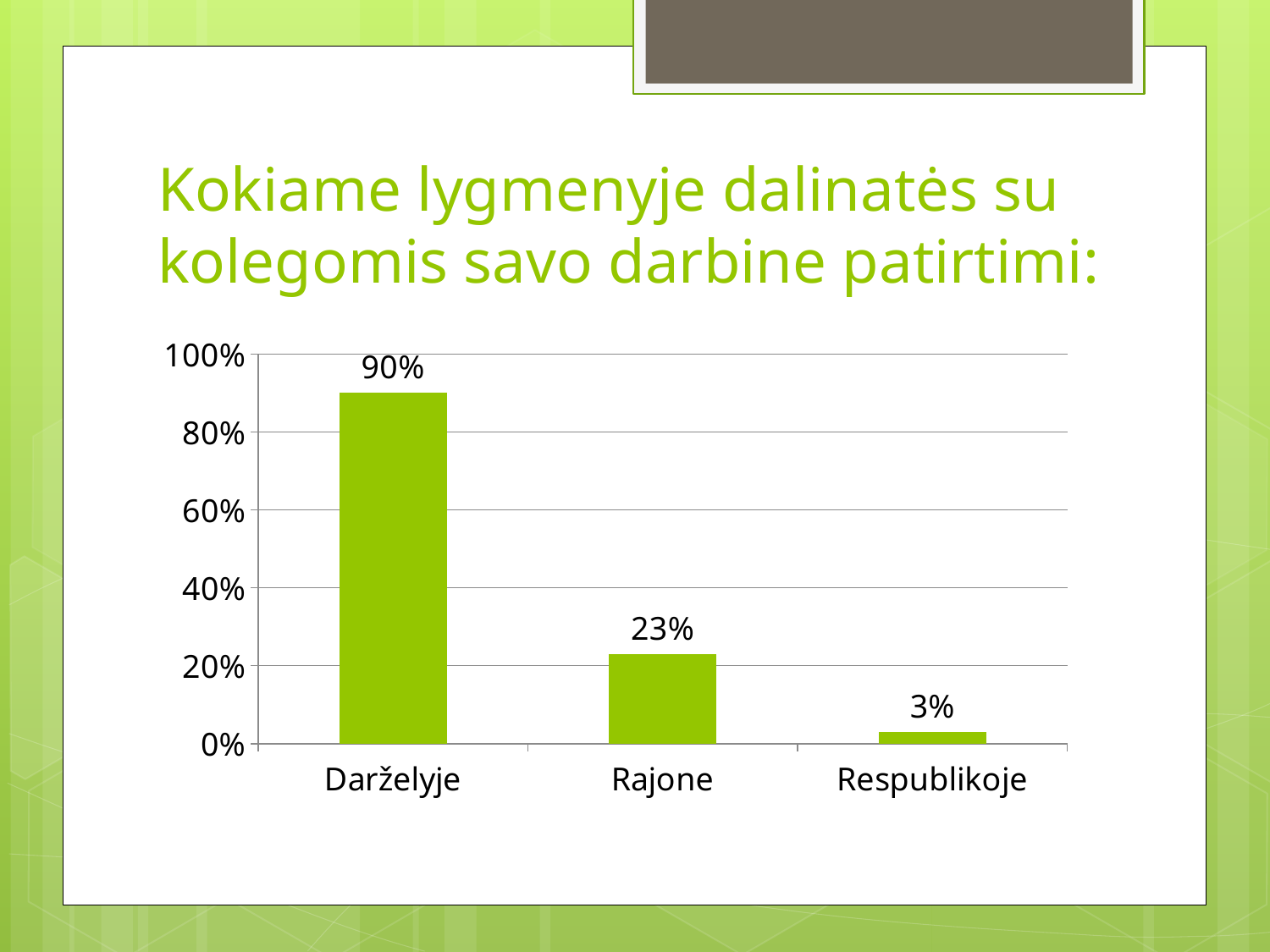
Which is larger, the value for Rajone or the value for Respublikoje? Rajone Do the values rise or fall from left to right along the x axis? fall Is the value for Darželyje greater or less than 80%? greater How many categories are shown on the x axis? 3 What is the difference between the values for Darželyje and Rajone? 67% Which category has the lowest value? Respublikoje What is the value for Respublikoje? 3% What is the value for Rajone? 23% What kind of chart is shown on the slide? bar chart Which category has the highest value? Darželyje What is the difference between the values for Rajone and Respublikoje? 20% What is the value for Darželyje? 90%